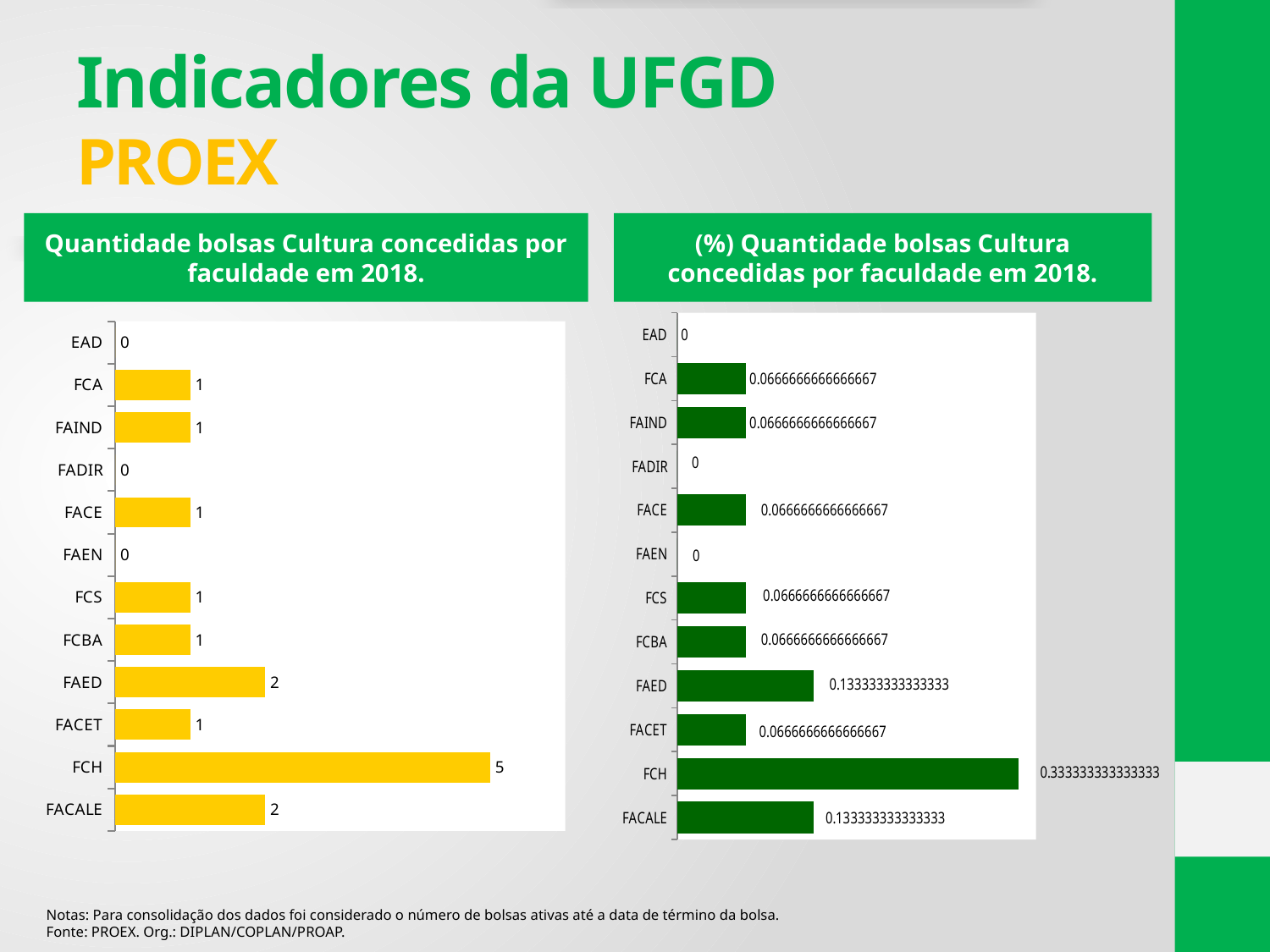
In the right chart, '(%) Quantidade bolsas Cultura concedidas por faculdade em 2018', what is the value for FCH? 0.333333333333333 What kind of chart is the left chart, 'Quantidade bolsas Cultura concedidas por faculdade em 2018'? Bar chart In the right chart, '(%) Quantidade bolsas Cultura concedidas por faculdade em 2018', what is the value for FACALE? 0.133333333333333 In the left chart, 'Quantidade bolsas Cultura concedidas por faculdade em 2018', which faculty has the highest value? FCH In the left chart, 'Quantidade bolsas Cultura concedidas por faculdade em 2018', what is the difference between the values for FCH and FACALE? 3 What colour are the bars in the right chart, '(%) Quantidade bolsas Cultura concedidas por faculdade em 2018'? Green In the right chart, '(%) Quantidade bolsas Cultura concedidas por faculdade em 2018', what is the value for FCA? 0.0666666666666667 In the left chart, 'Quantidade bolsas Cultura concedidas por faculdade em 2018', what is the value for FAED? 2 In the left chart, 'Quantidade bolsas Cultura concedidas por faculdade em 2018', what is the value for FCH? 5 In the left chart, 'Quantidade bolsas Cultura concedidas por faculdade em 2018', how many faculties are listed? 12 In the right chart, '(%) Quantidade bolsas Cultura concedidas por faculdade em 2018', which is larger, the value for FAED or the value for FCBA? FAED In the left chart, 'Quantidade bolsas Cultura concedidas por faculdade em 2018', which is larger, the value for FAED or the value for FACET? FAED